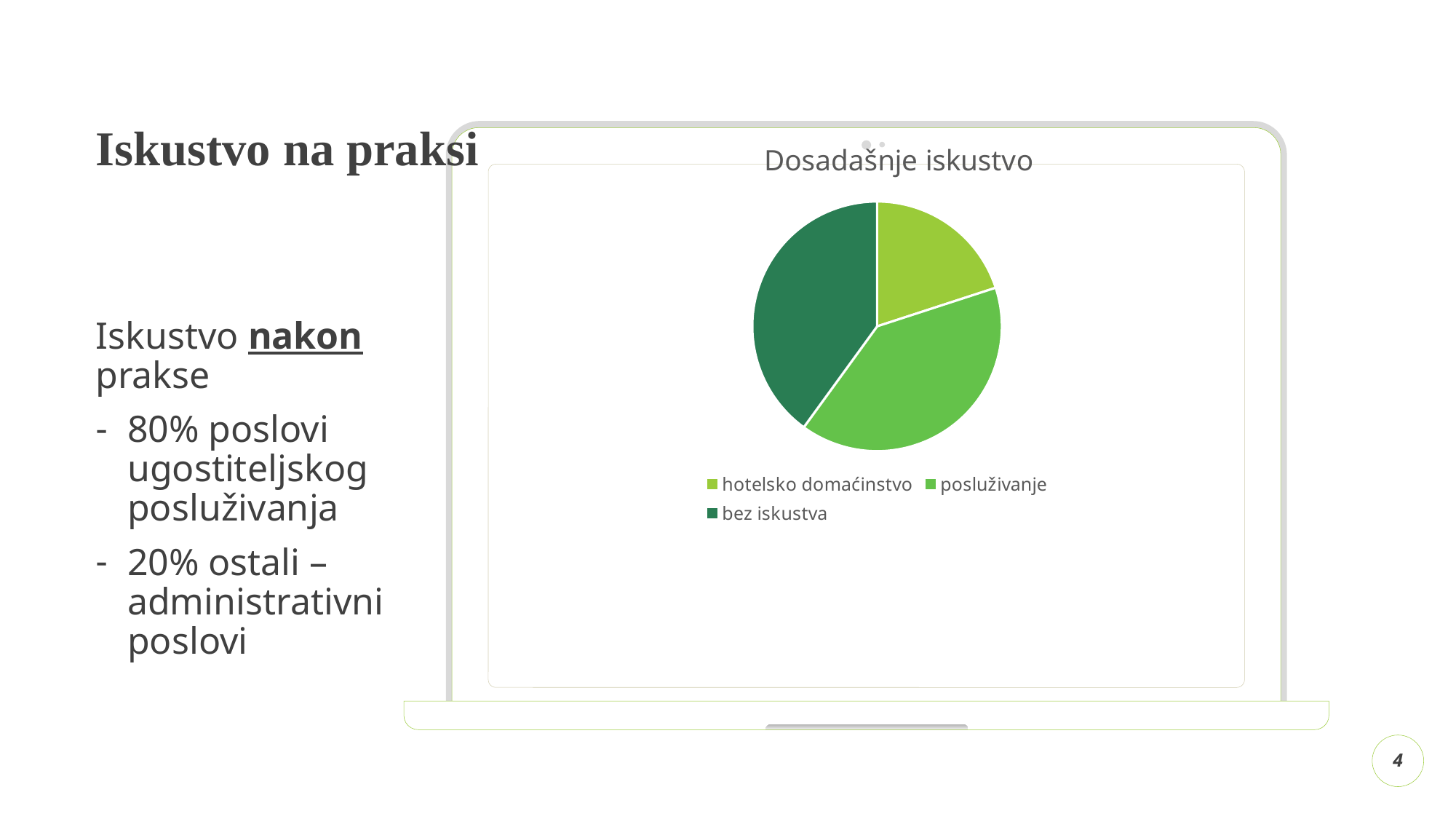
How many entries does the chart's legend list? 3 What is the title of the chart on the slide? Dosadašnje iskustvo Which slice is larger: hotelsko domaćinstvo or bez iskustva? bez iskustva Which slice is larger: hotelsko domaćinstvo or posluživanje? posluživanje What kind of chart is shown on the slide? pie chart Which category has the smallest slice in the pie chart? hotelsko domaćinstvo How many slices does the pie chart have? 3 Which legend entry is shown in the darkest green colour? bez iskustva